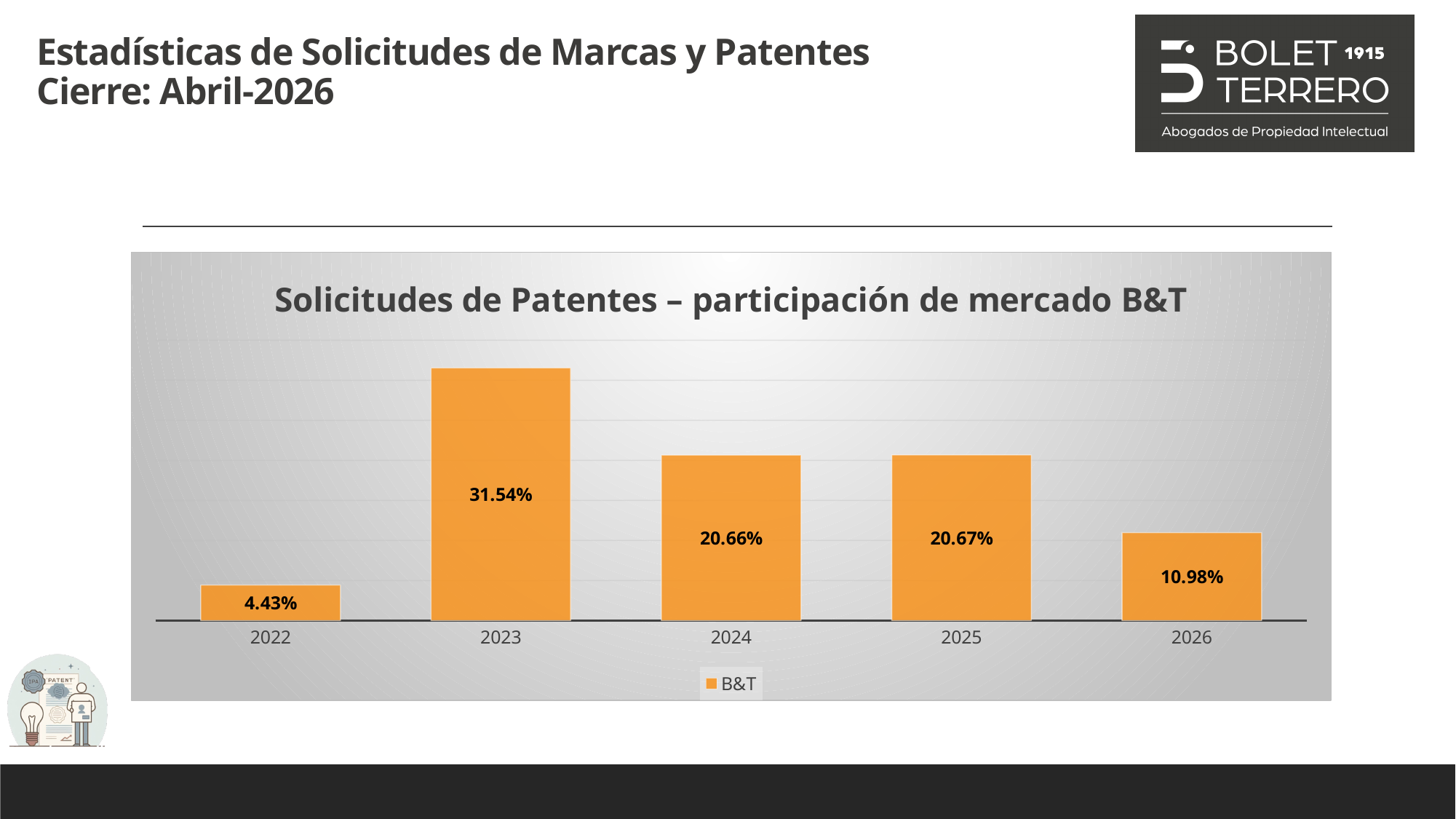
What is the B&T market share for 2022? 4.43% How many series does the legend list? 1 What is the B&T market share for 2024? 20.66% Which year has the highest B&T market share? 2023 Which is larger, the value for 2023 or the value for 2026? 2023 Which year has the lowest B&T market share? 2022 What kind of chart is shown? Bar chart What is the difference between the 2025 and 2026 values? 9.69% What is the B&T market share for 2023? 31.54% How many years are shown on the x axis? 5 What is the B&T market share for 2026? 10.98% What is the difference between the 2023 and 2022 values? 27.11%